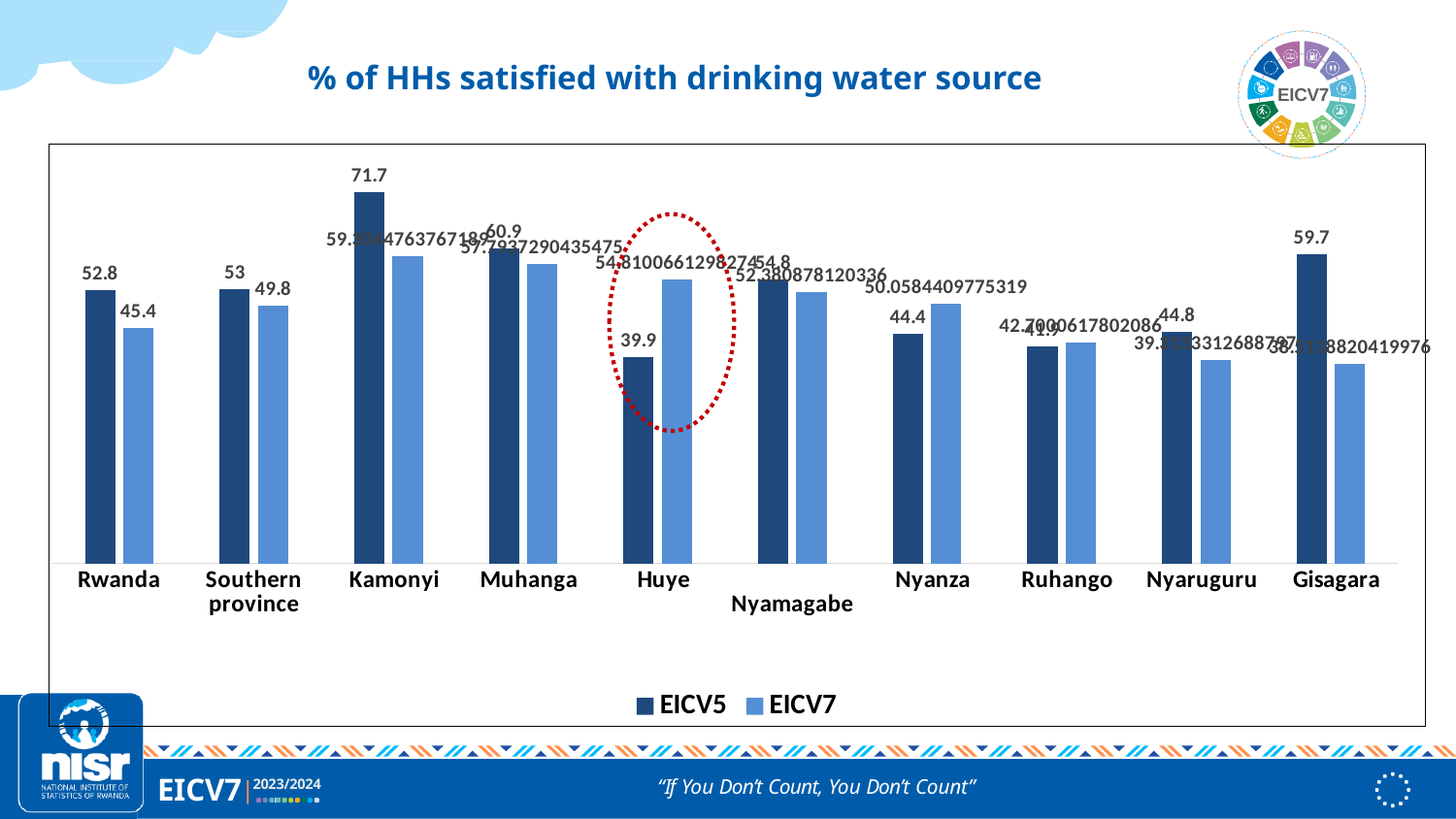
What is the EICV5 value for Rwanda? 52.8 What is the EICV5 value for Huye? 39.9 Which category has the lowest EICV5 value? Huye How many categories are shown on the x axis? 10 Which category has the highest EICV5 value? Kamonyi What type of chart is shown on the slide? Bar chart What is the EICV7 value for Southern province? 49.8 What is the EICV7 value for Rwanda? 45.4 How many series does the legend list? 2 For Huye, which is larger, the EICV5 value or the EICV7 value? EICV7 What is the EICV5 value for Gisagara? 59.7 What is the difference between the EICV5 and EICV7 values for Rwanda? 7.4